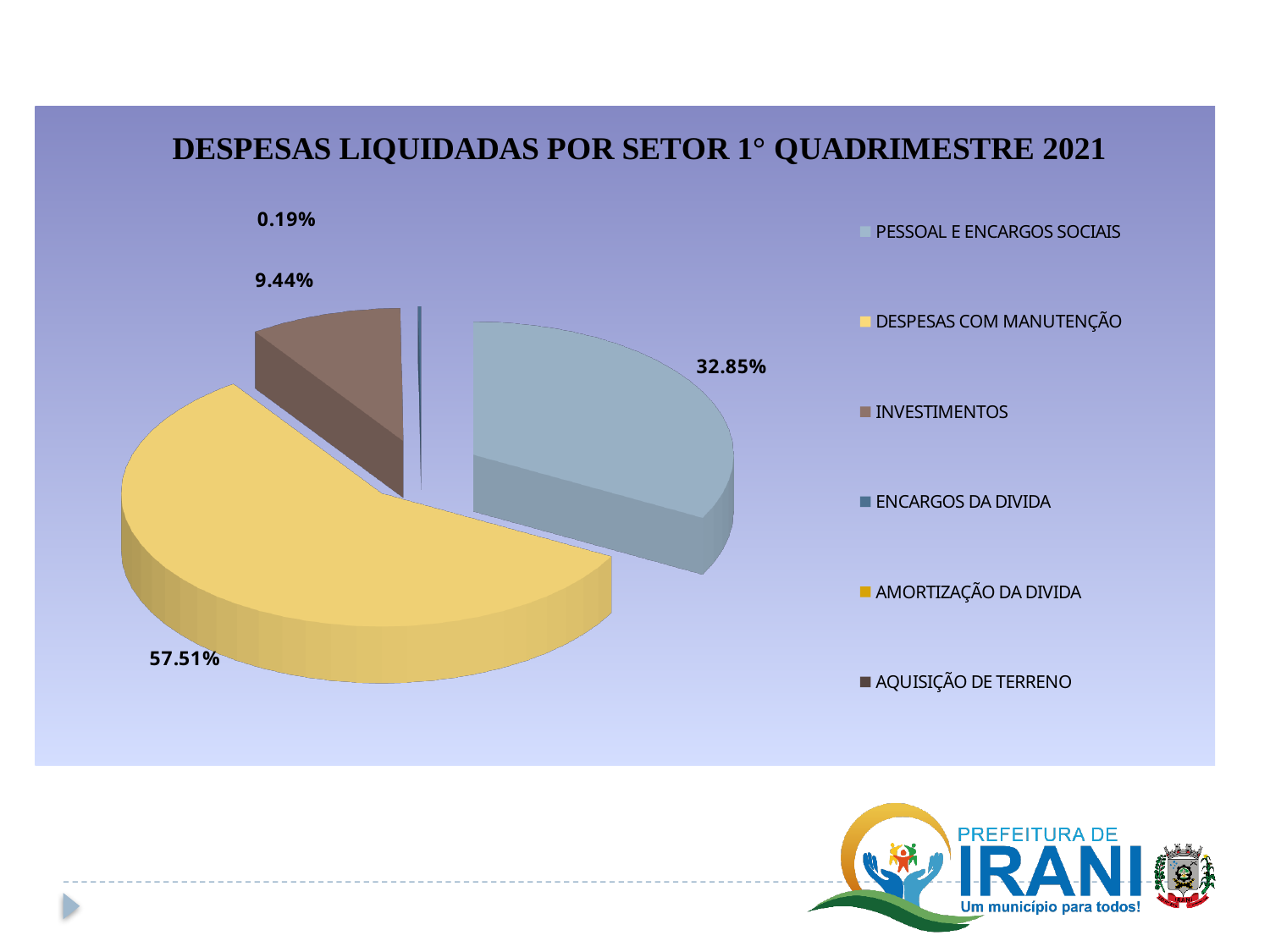
What is the difference in percentage points between PESSOAL E ENCARGOS SOCIAIS and INVESTIMENTOS? 23.41 percentage points What share of the pie does INVESTIMENTOS represent? 9.44% What share of the pie does DESPESAS COM MANUTENÇÃO represent? 57.51% What share of the pie does PESSOAL E ENCARGOS SOCIAIS represent? 32.85% What is the title of the chart? DESPESAS LIQUIDADAS POR SETOR 1° QUADRIMESTRE 2021 What kind of chart is shown on the slide? Pie chart Which category has the largest slice of the pie? DESPESAS COM MANUTENÇÃO How many categories does the legend list? 6 What is the difference in percentage points between DESPESAS COM MANUTENÇÃO and PESSOAL E ENCARGOS SOCIAIS? 24.66 percentage points Which category is represented by the yellow slice? DESPESAS COM MANUTENÇÃO Which is larger, the share for PESSOAL E ENCARGOS SOCIAIS or the share for INVESTIMENTOS? PESSOAL E ENCARGOS SOCIAIS What is the smallest percentage label shown on the pie? 0.19%